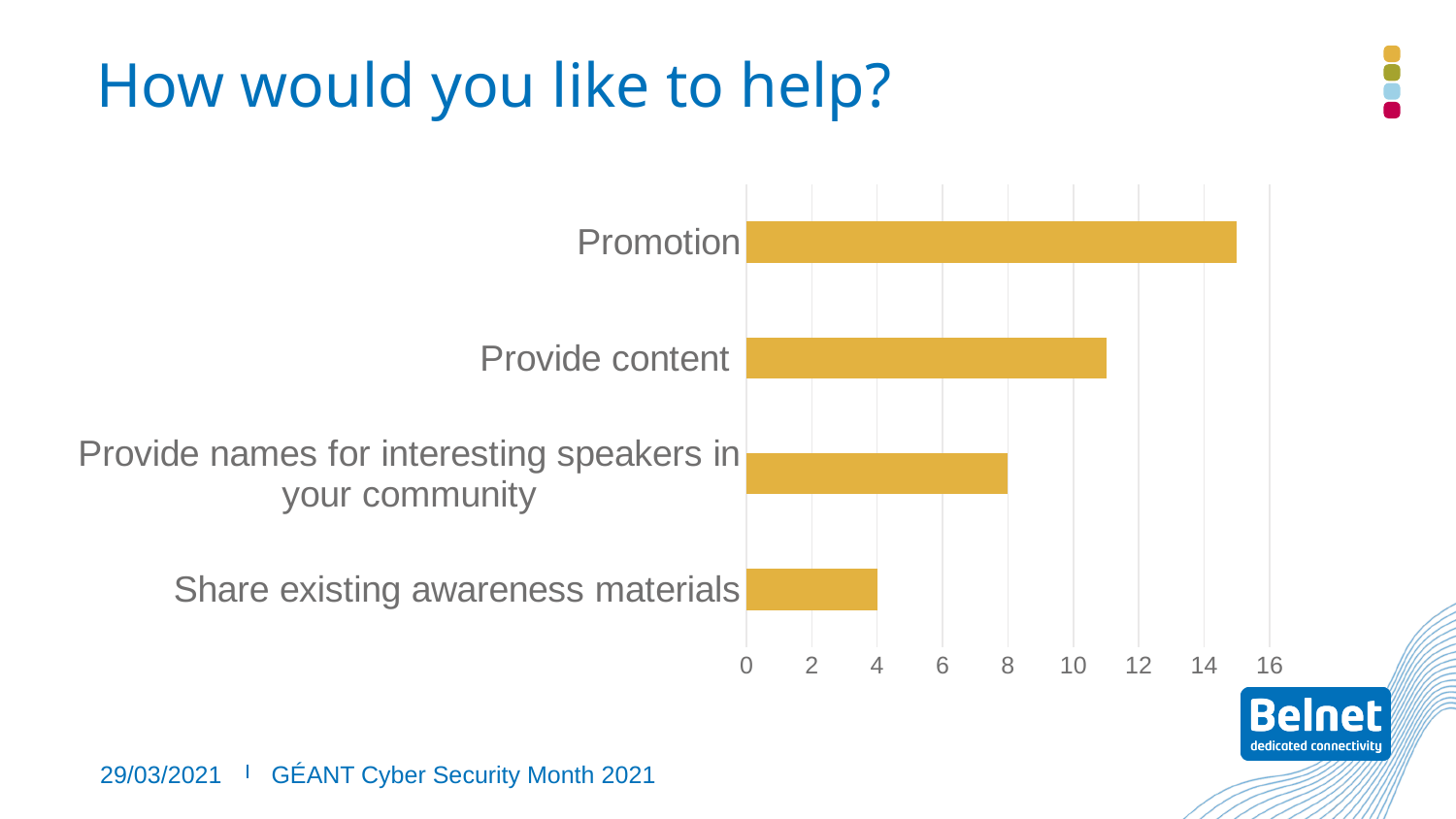
Which category has the highest value? Promotion Is the value for 'Provide content' greater or less than 12? less How many categories does the chart show? 4 What is the title of the slide containing the chart? How would you like to help? Is the value for Promotion greater or less than 14? greater What is the difference between the values for 'Provide names for interesting speakers in your community' and 'Share existing awareness materials'? 4 What is the value for 'Share existing awareness materials'? 4 What is the value for 'Provide names for interesting speakers in your community'? 8 Is the value for 'Provide content' greater or less than 10? greater Which category has the lowest value? Share existing awareness materials Which is larger, the value for Promotion or the value for 'Provide content'? Promotion What kind of chart is shown on the slide? bar chart